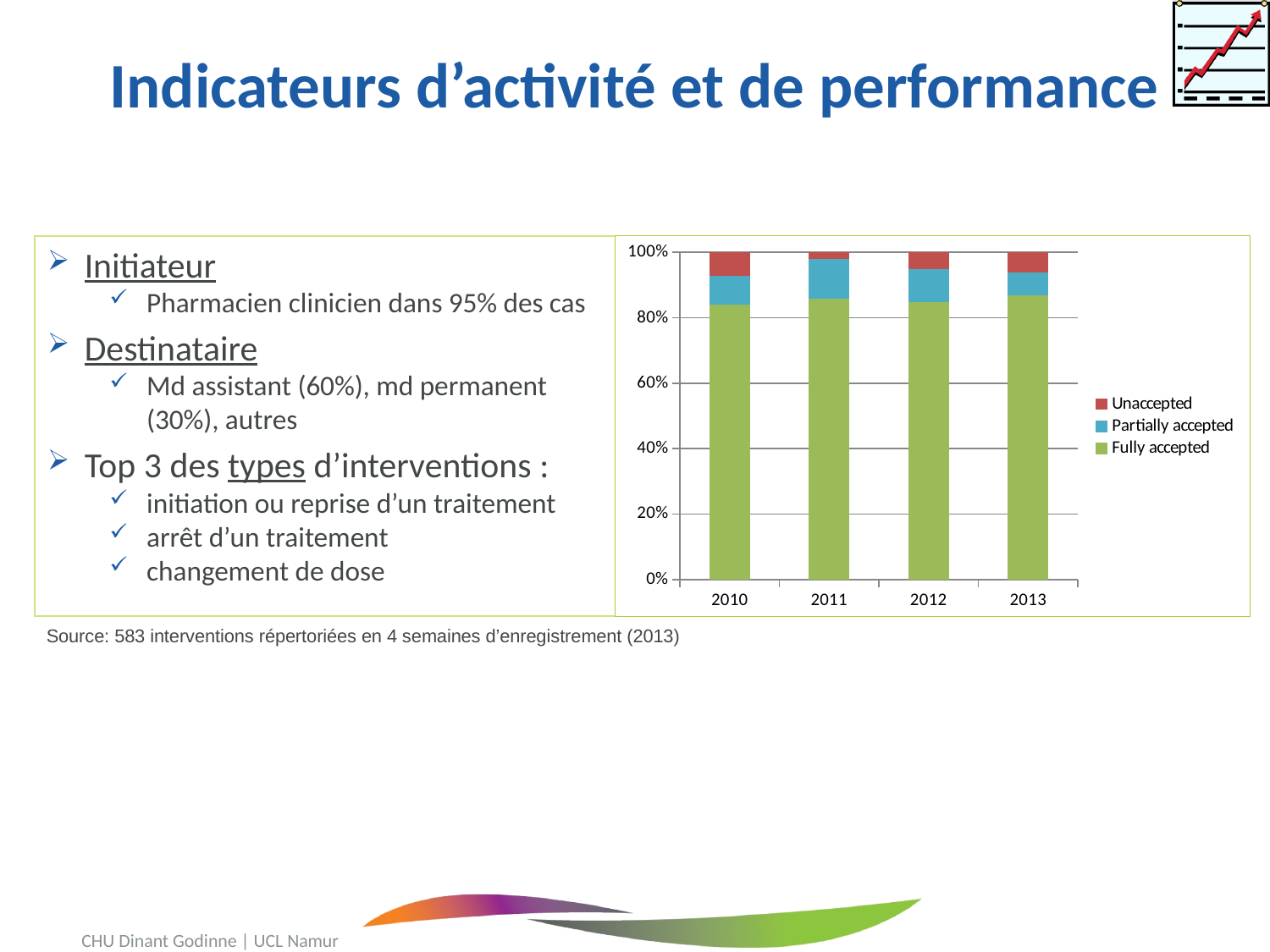
Is the Fully accepted value for 2010 greater or less than 80%? greater What kind of chart is shown on the slide? Stacked bar chart Is the Fully accepted value for 2013 greater or less than 80%? greater How many years are shown on the x axis of the chart? 4 In 2010, which is larger: the Fully accepted share or the Unaccepted share? Fully accepted Which series has the largest share in 2012? Fully accepted Which series has the smallest share in 2011? Unaccepted How many series does the chart legend list? 3 What colour represents the Fully accepted series in the chart? Green Is the Partially accepted value for 2011 greater or less than 20%? less Which series are listed in the chart legend? Unaccepted, Partially accepted, Fully accepted What is the total height of each stacked bar in the chart? 100%